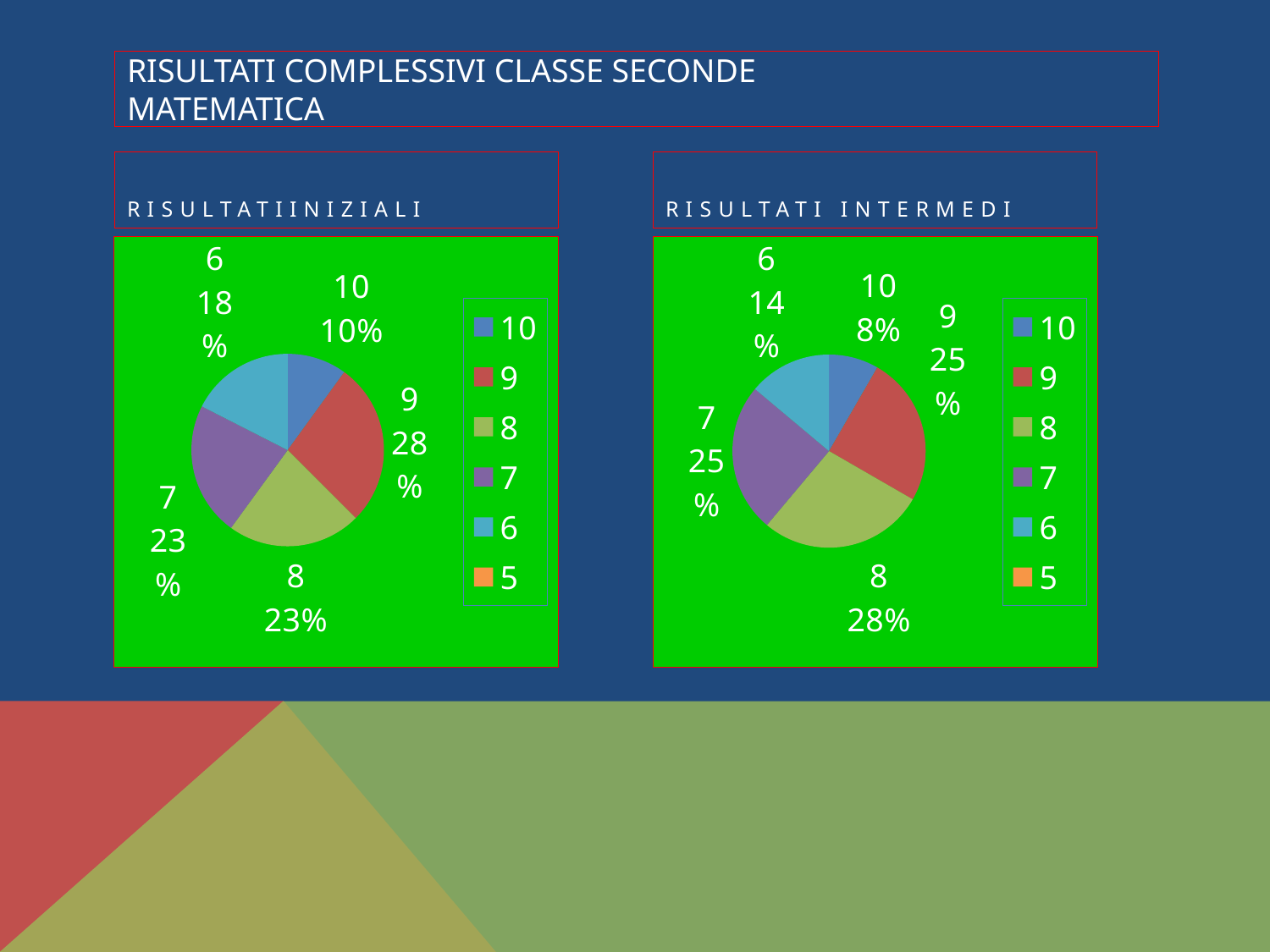
In the RISULTATI INIZIALI chart, which grade has the largest share? 9 In the RISULTATI INTERMEDI chart, which has a larger share, grade 8 or grade 9? 8 In the RISULTATI INTERMEDI chart, which grade has the smallest share? 10 How many entries does the legend of the RISULTATI INTERMEDI chart list? 6 In the RISULTATI INTERMEDI chart, what is the difference between the shares of grade 8 and grade 6? 14% In the RISULTATI INIZIALI chart, what share does grade 6 have? 18% In the RISULTATI INTERMEDI chart, what share does grade 8 have? 28% What is the title of the chart on the right side of the slide? RISULTATI INTERMEDI In the RISULTATI INIZIALI chart, what is the difference between the shares of grade 9 and grade 10? 18% In the RISULTATI INIZIALI chart, what share does grade 9 have? 28% In the RISULTATI INTERMEDI chart, what share does grade 10 have? 8% What type of chart is the RISULTATI INIZIALI chart? pie chart